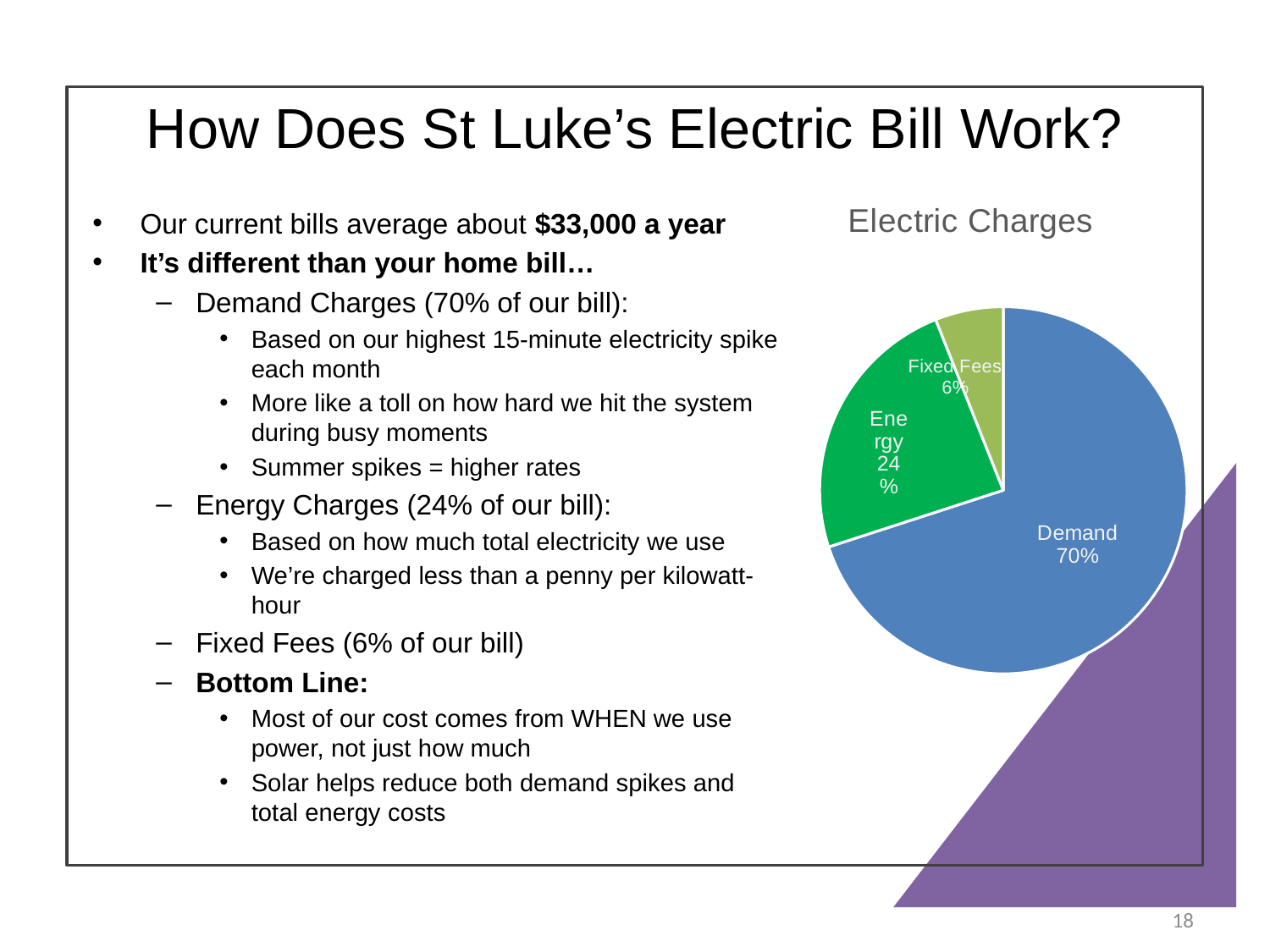
What share of the pie does Fixed Fees represent? 6% How many slices does the pie chart have? 3 What share of the pie does Energy represent? 24% What is the difference in percentage points between the Demand slice and the Energy slice? 46 What colour is the Demand slice of the pie? blue What kind of chart is shown on the slide? pie chart What is the combined share of the Energy and Fixed Fees slices? 30% Which slice of the pie is the smallest? Fixed Fees What share of the pie does Demand represent? 70% Which slice of the pie is the largest? Demand What is the title of the chart? Electric Charges Which is larger, the Energy slice or the Fixed Fees slice? Energy